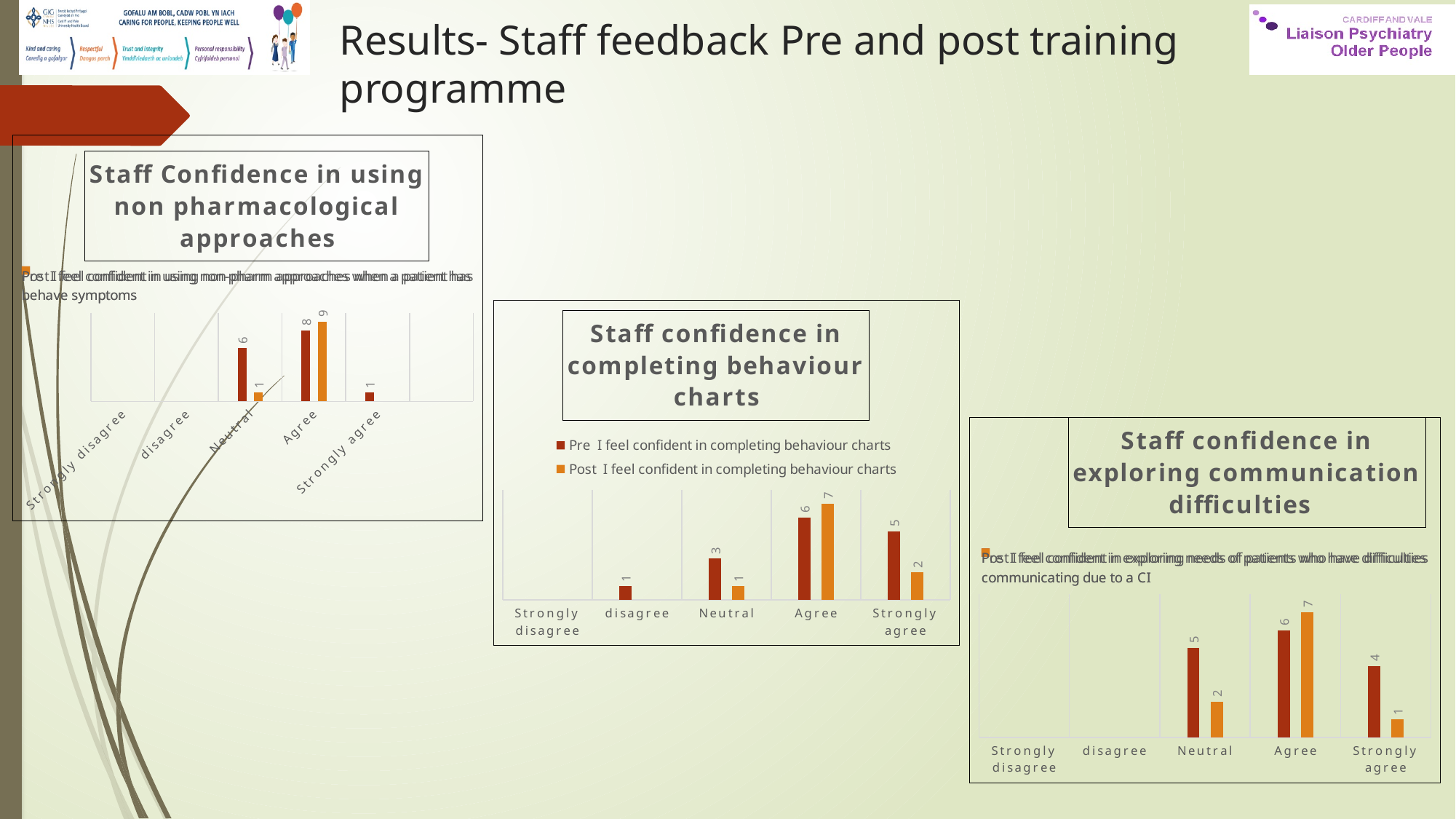
In the 'Staff Confidence in using non pharmacological approaches' chart, which is larger for Agree: the red bar or the orange bar? the orange bar In the 'Staff confidence in completing behaviour charts' chart, what is the Pre value for Agree? 6 What type of chart is the 'Staff confidence in completing behaviour charts' chart? bar chart How many series does the legend of the 'Staff confidence in completing behaviour charts' chart list? 2 In the 'Staff Confidence in using non pharmacological approaches' chart, what is the value of the red bar for Neutral? 6 In the 'Staff confidence in completing behaviour charts' chart, what is the Post value for Strongly agree? 2 In the 'Staff confidence in exploring communication difficulties' chart, what is the difference between the red and orange bars for Neutral? 3 In the 'Staff confidence in completing behaviour charts' chart, which category has the highest Pre value? Agree In the 'Staff confidence in exploring communication difficulties' chart, what is the value of the orange bar for Agree? 7 In the 'Staff Confidence in using non pharmacological approaches' chart, what is the value of the orange bar for Agree? 9 How many categories are shown on the x axis of the 'Staff confidence in exploring communication difficulties' chart? 5 In the 'Staff confidence in completing behaviour charts' chart, what is the difference between the Pre and Post values for Neutral? 2